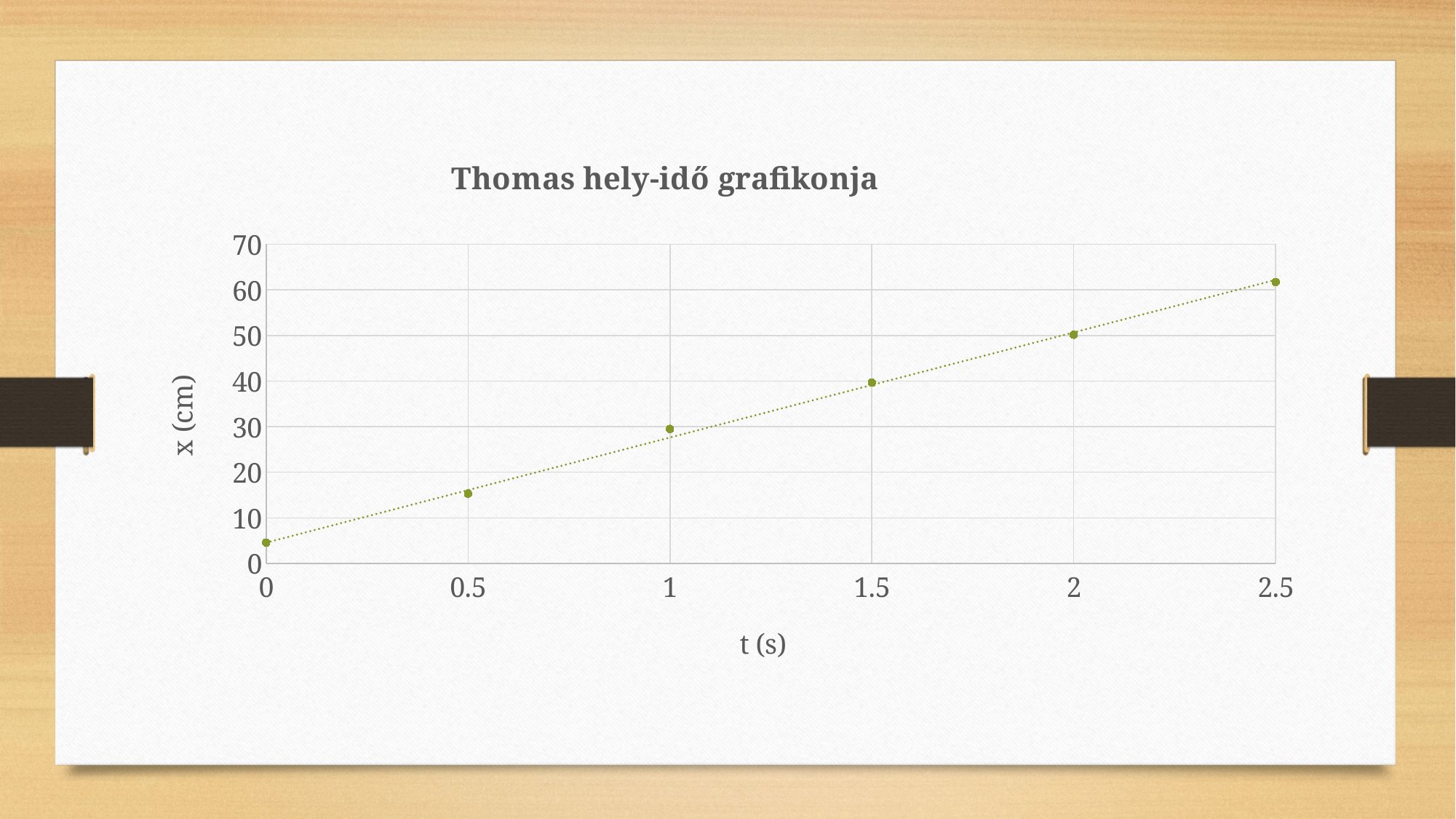
Do the values of x rise or fall as t increases? rise Which is larger, the value of x at t = 0.5 or at t = 2? t = 2 How many data points are plotted on the chart? 6 What kind of chart is shown on the slide? scatter chart Is the value of x at t = 1.5 greater or less than 30? greater At which value of t is x the highest? 2.5 Is the value of x at t = 2.5 greater or less than 60? greater What is the label of the vertical axis? x (cm) At which value of t is x the lowest? 0 What is the title of the chart? Thomas hely-idő grafikonja Is the value of x at t = 1 greater or less than 20? greater